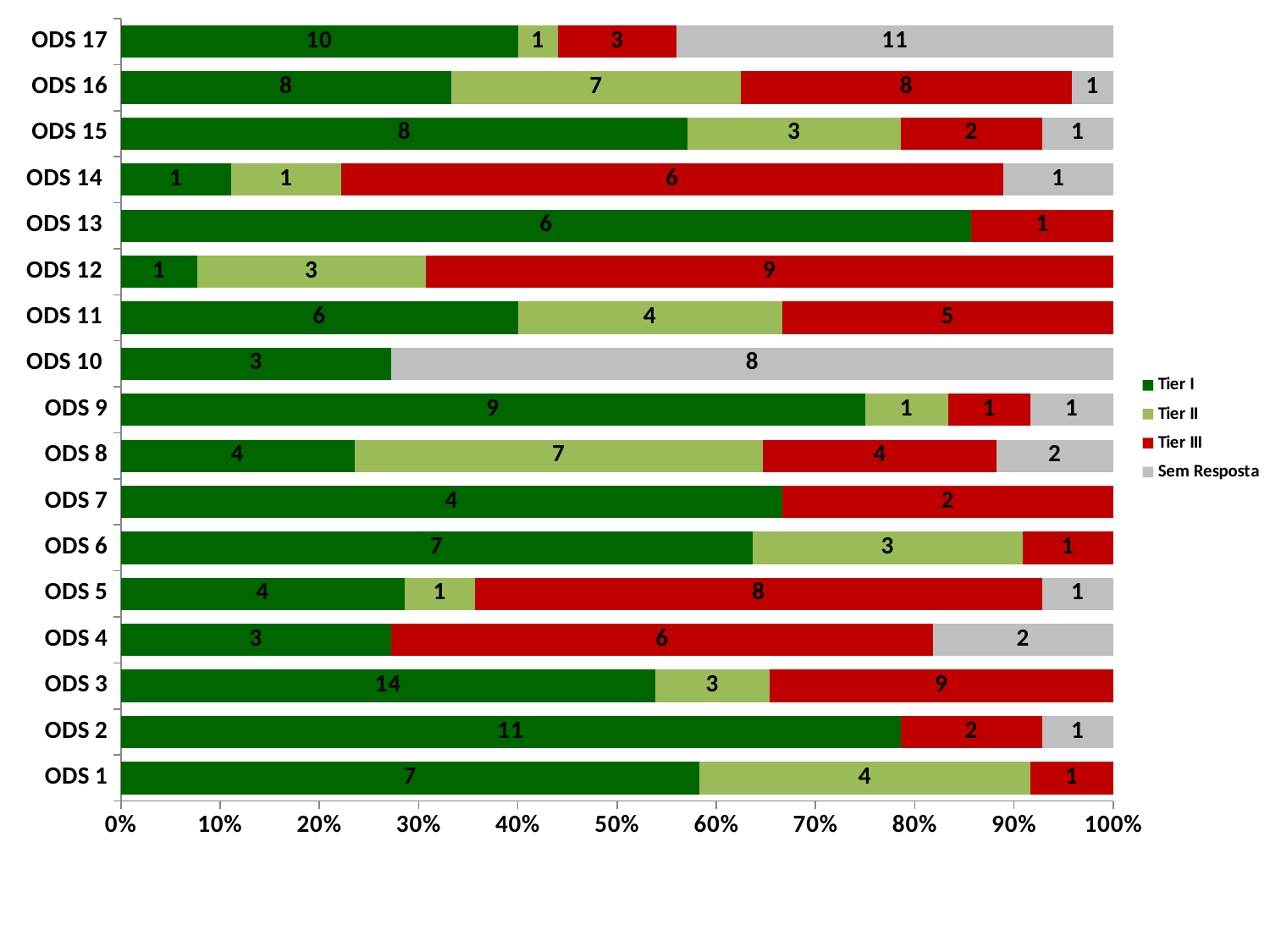
What is the Tier I value for ODS 3? 14 What is the total of all segments in the ODS 8 bar? 17 What is the total of all segments in the ODS 16 bar? 24 Which is larger, the Tier II value for ODS 16 or the Tier II value for ODS 11? ODS 16 Which ODS has the highest Tier I value? ODS 3 What is the difference between the Tier III values of ODS 5 and ODS 15? 6 Does the Tier I segment for ODS 13 end at greater or less than 80% on the axis? greater How many ODS categories are shown on the chart? 17 What is the Tier III value for ODS 12? 9 What is the Sem Resposta value for ODS 17? 11 What kind of chart is shown on the slide? Stacked bar chart How many series does the legend list? 4